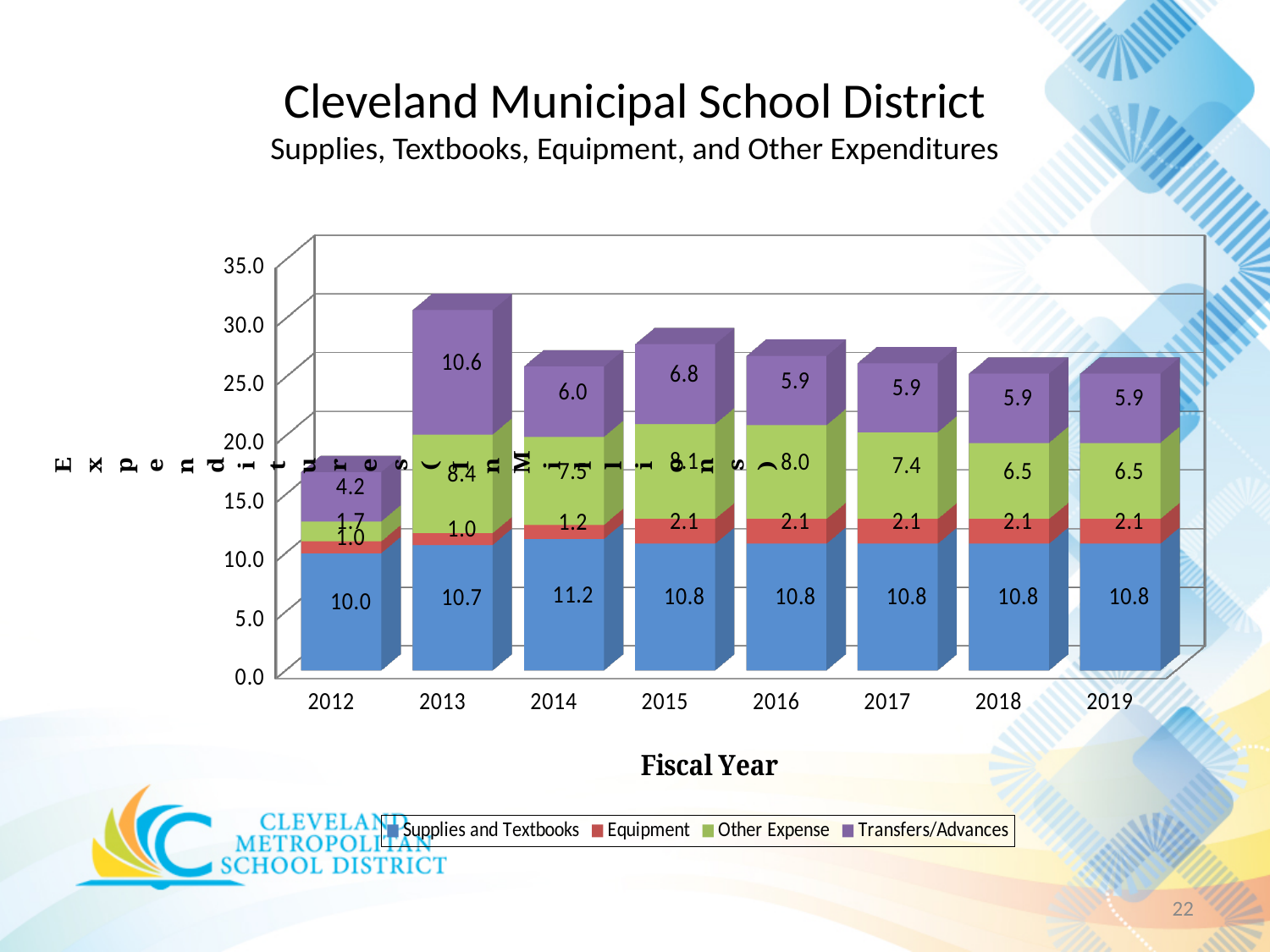
Which year has the larger Other Expense value, 2016 or 2017? 2016 In which fiscal year is the Transfers/Advances value highest? 2013 In which fiscal year is the Supplies and Textbooks value lowest? 2012 How many fiscal years are shown on the x axis? 8 What is the value for Transfers/Advances in 2013? 10.6 What is the value for Equipment in 2019? 2.1 What is the difference between the Transfers/Advances values for 2013 and 2014? 4.6 What is the total of the stacked bar for 2012? 16.9 What kind of chart is shown on the slide? Stacked bar chart How many series does the legend list? 4 What is the title of the x axis? Fiscal Year What is the value for Supplies and Textbooks in 2014? 11.2